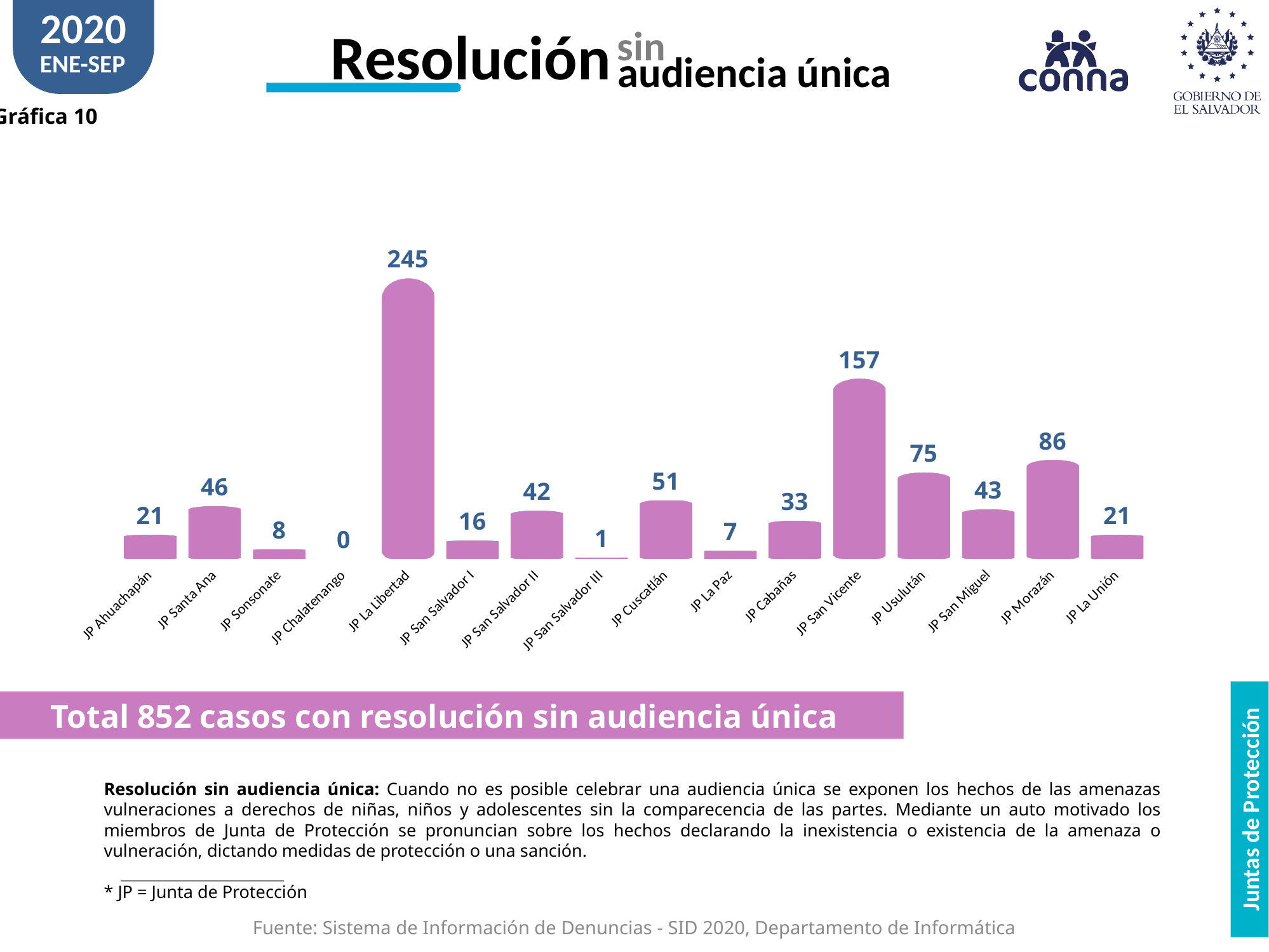
What is the difference between the values for JP La Libertad and JP San Vicente? 88 Which category has the lowest value? JP Chalatenango What is the difference between the values for JP Santa Ana and JP Sonsonate? 38 What is the value for JP San Vicente? 157 What total number of cases is stated in the banner below the chart? 852 What is the value for JP Chalatenango? 0 What is the value for JP La Libertad? 245 Which category has the highest value? JP La Libertad What kind of chart is shown on the slide? Bar chart What is the value for JP Morazán? 86 How many categories are shown on the x axis? 16 Which is larger, the value for JP Usulután or the value for JP Cuscatlán? JP Usulután